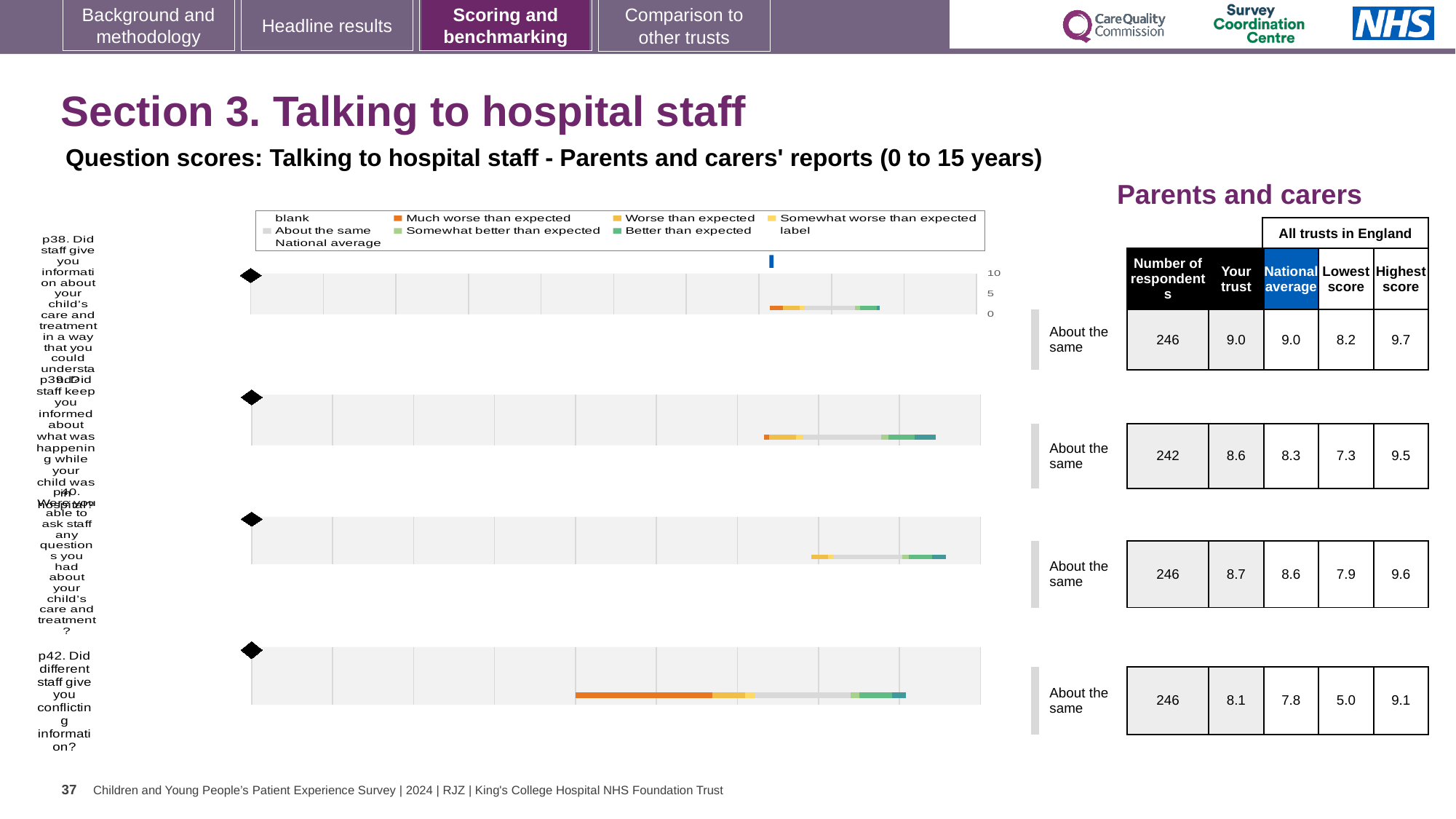
What is the difference between the 'Your trust' score and the national average for p39? 0.3 Which question has the highest 'Highest score' across all trusts in England? p38 How many respondents answered p39? 242 How many questions (bars) are plotted in the chart? 4 What is the national average score for p42 (Did different staff give you conflicting information)? 7.8 For p40, which is larger: the 'Your trust' score or the national average? Your trust Which question has the lowest 'Your trust' score? p42 What is the highest score among all trusts in England for p39? 9.5 What is the lowest score among all trusts in England for p42? 5.0 What type of chart is used to show the question scores on this slide? bar chart What benchmark category is shown next to each of the four question bars? About the same What is the 'Your trust' score for p38 (Did staff give you information about your child's care and treatment in a way that you could understand)? 9.0